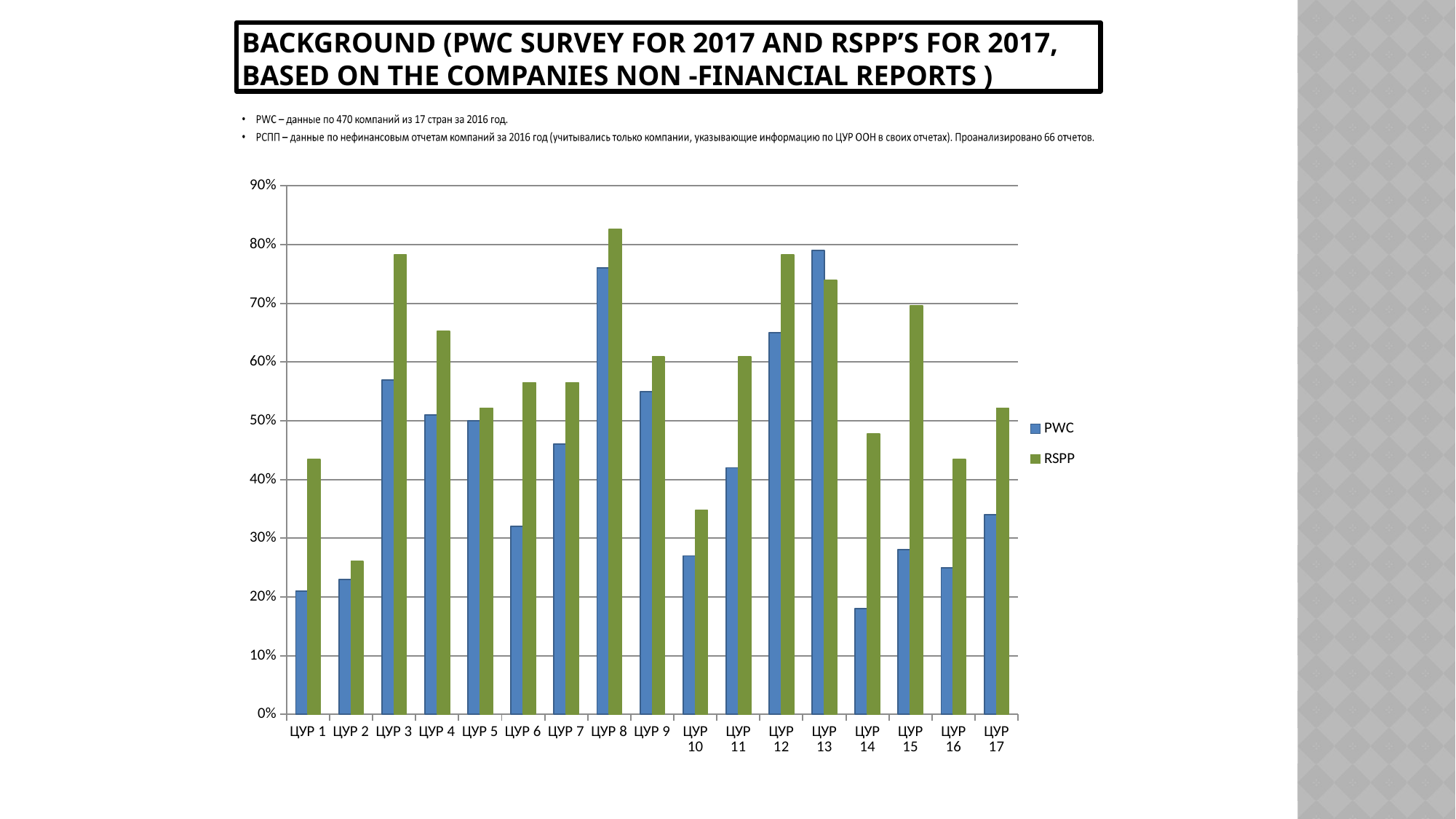
Which category has the lowest PWC value? ЦУР 14 Which category has the highest PWC value? ЦУР 13 How many categories (ЦУР) are shown on the x axis? 17 Which series is shown in green in the legend? RSPP Which category has the lowest RSPP value? ЦУР 2 Is the RSPP value for ЦУР 14 greater or less than 50%? less What kind of chart is shown on the slide? Bar chart Which category has the highest RSPP value? ЦУР 8 For ЦУР 13, which series has the larger value, PWC or RSPP? PWC Is the PWC value for ЦУР 8 greater or less than 70%? greater How many series does the legend list? 2 Is the PWC value for ЦУР 14 greater or less than 20%? less